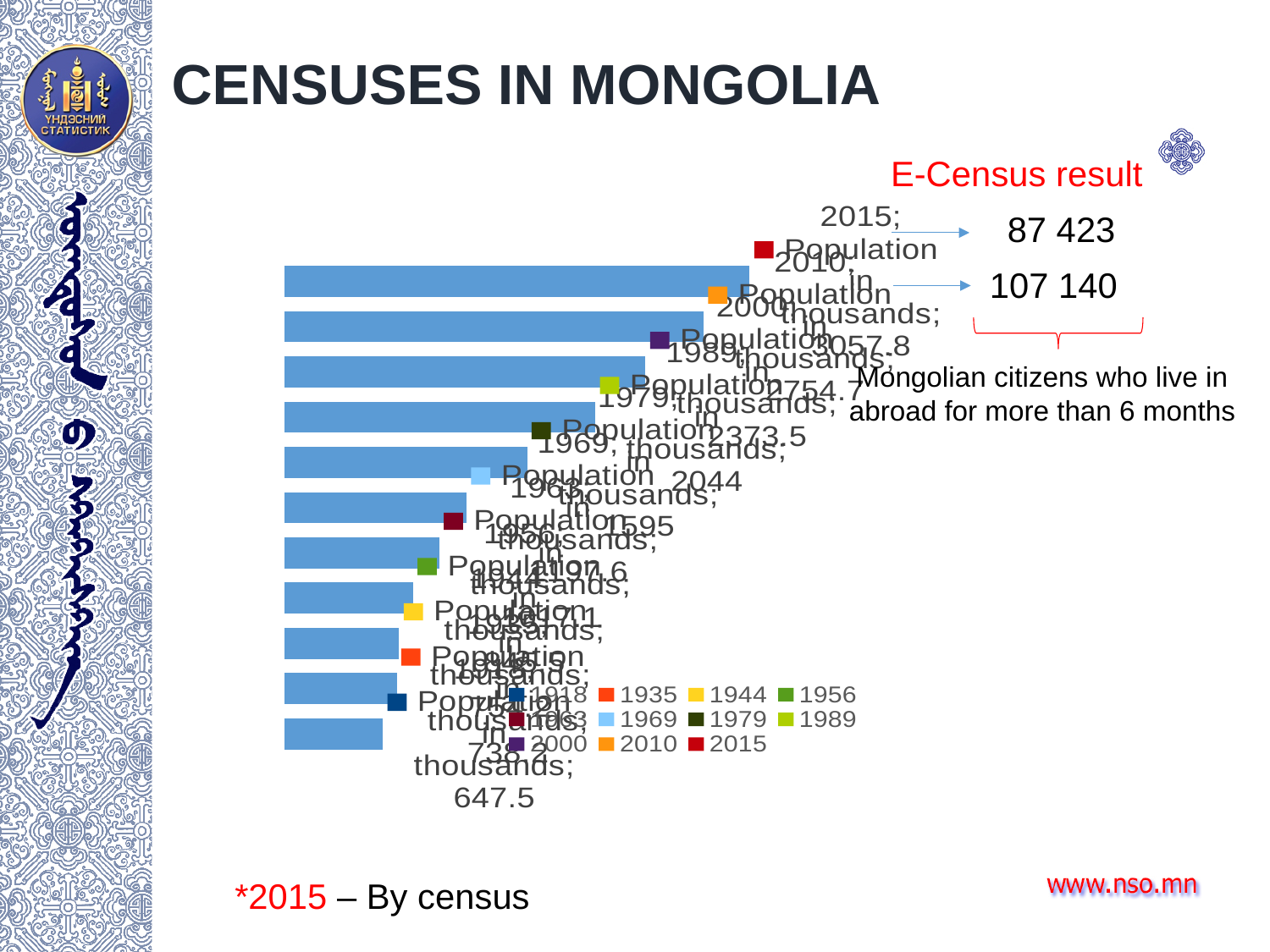
Which is larger in the chart, the population for 2000 or for 1989? 2000 Which census year has the longest bar in the chart? 2015 Do the bars get longer or shorter going from the bottom of the chart to the top? longer What is the population in thousands for 2010 according to the chart? 2754.7 What is the population in thousands for 2015 according to the chart? 3057.8 What is the population in thousands for 1979 according to the chart? 1595 What is the difference between the 2015 and 2010 population values in the chart? 303.1 How many bars are plotted in the chart? 11 What is the difference between the 2010 and 2000 population values in the chart? 381.2 What is the population in thousands for 1989 according to the chart? 2044 What is the population in thousands for 2000 according to the chart? 2373.5 What kind of chart is shown on the slide? bar chart